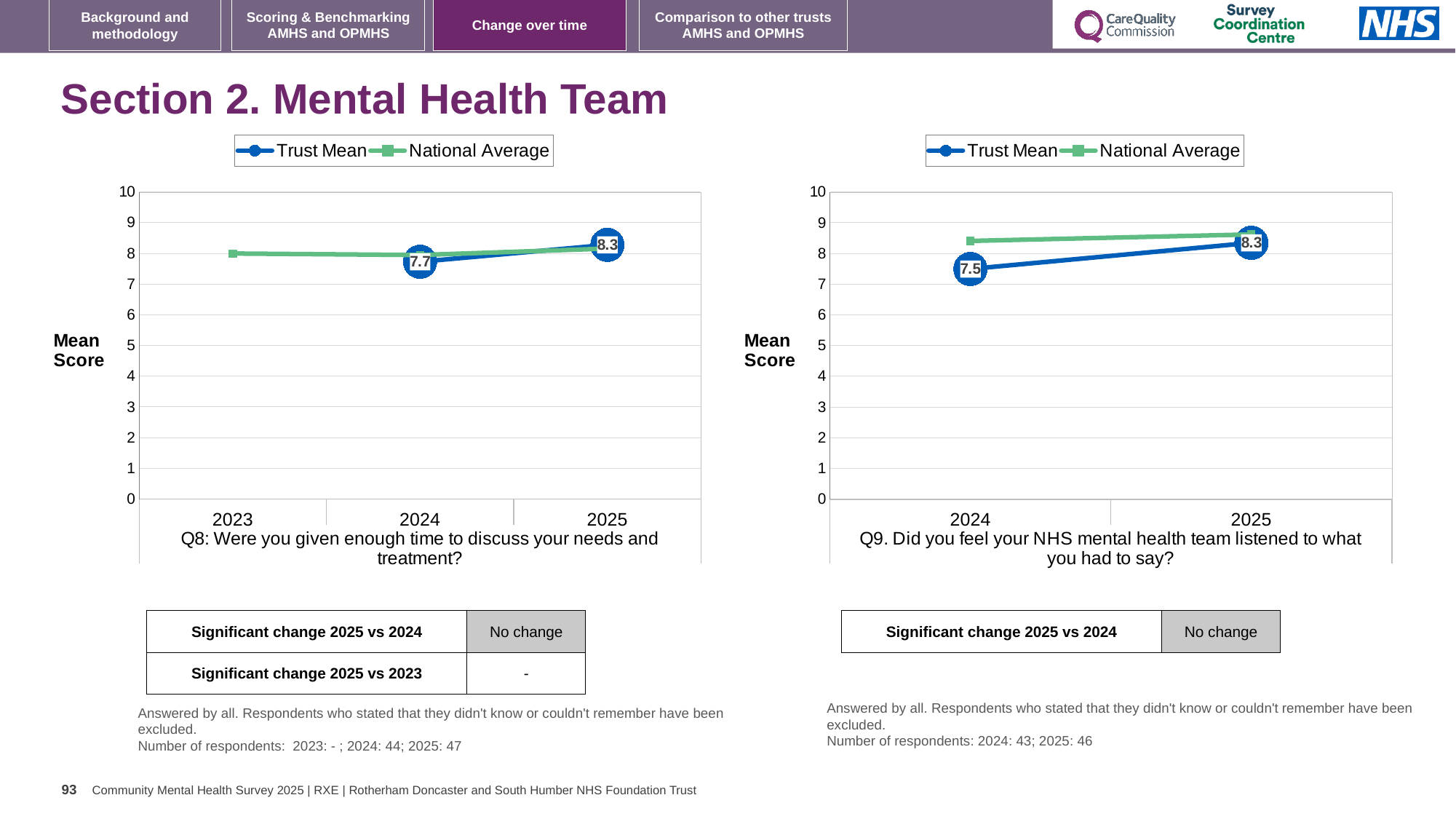
How many series does the legend of the right chart (Q9) list? 2 On the right chart (Q9), what is the Trust Mean value for 2024? 7.5 On the right chart (Q9), what is the Trust Mean value for 2025? 8.3 On the right chart (Q9), in 2024 which is larger, the Trust Mean or the National Average? National Average On the right chart (Q9), does the Trust Mean rise or fall from 2024 to 2025? rise On the left chart (Q8), what is the Trust Mean value for 2025? 8.3 How many years are shown on the x axis of the left chart (Q8)? 3 On the left chart (Q8), is the National Average value for 2023 greater or less than 7? greater What kind of chart is the left chart (Q8)? line chart On the right chart (Q9), what is the difference between the Trust Mean in 2025 and in 2024? 0.8 On the left chart (Q8), what is the Trust Mean value for 2024? 7.7 On the left chart (Q8), by how much did the Trust Mean change from 2024 to 2025? 0.6